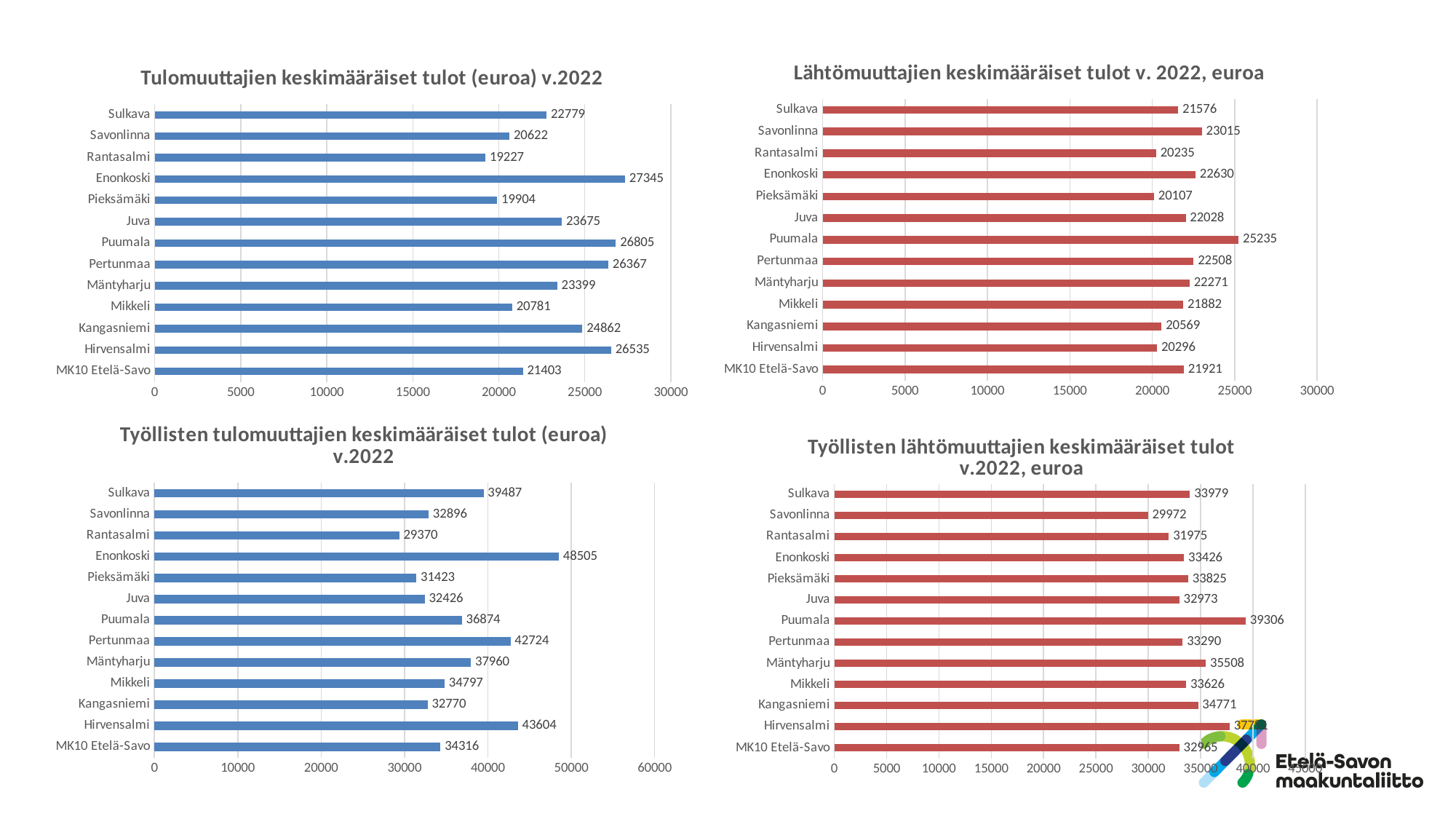
In the chart titled "Lähtömuuttajien keskimääräiset tulot v. 2022, euroa", which category has the highest value? Puumala In the chart titled "Työllisten lähtömuuttajien keskimääräiset tulot v.2022, euroa", what is the value for Mäntyharju? 35508 In the chart titled "Lähtömuuttajien keskimääräiset tulot v. 2022, euroa", what is the difference between Savonlinna and Rantasalmi? 2780 In the chart titled "Tulomuuttajien keskimääräiset tulot (euroa) v.2022", which municipality has the lowest value? Rantasalmi In the chart titled "Työllisten tulomuuttajien keskimääräiset tulot (euroa) v.2022", which category has the highest value? Enonkoski How many municipalities/categories are shown in the chart titled "Tulomuuttajien keskimääräiset tulot (euroa) v.2022"? 13 In the chart titled "Tulomuuttajien keskimääräiset tulot (euroa) v.2022", what is the value for Enonkoski? 27345 In the chart titled "Työllisten tulomuuttajien keskimääräiset tulot (euroa) v.2022", which is larger, Pertunmaa or Puumala? Pertunmaa In the chart titled "Työllisten lähtömuuttajien keskimääräiset tulot v.2022, euroa", which category has the lowest value? Savonlinna In the chart titled "Työllisten tulomuuttajien keskimääräiset tulot (euroa) v.2022", what is the value for Hirvensalmi? 43604 In the chart titled "Lähtömuuttajien keskimääräiset tulot v. 2022, euroa", what is the value for MK10 Etelä-Savo? 21921 What type of chart is the chart titled "Lähtömuuttajien keskimääräiset tulot v. 2022, euroa"? Bar chart